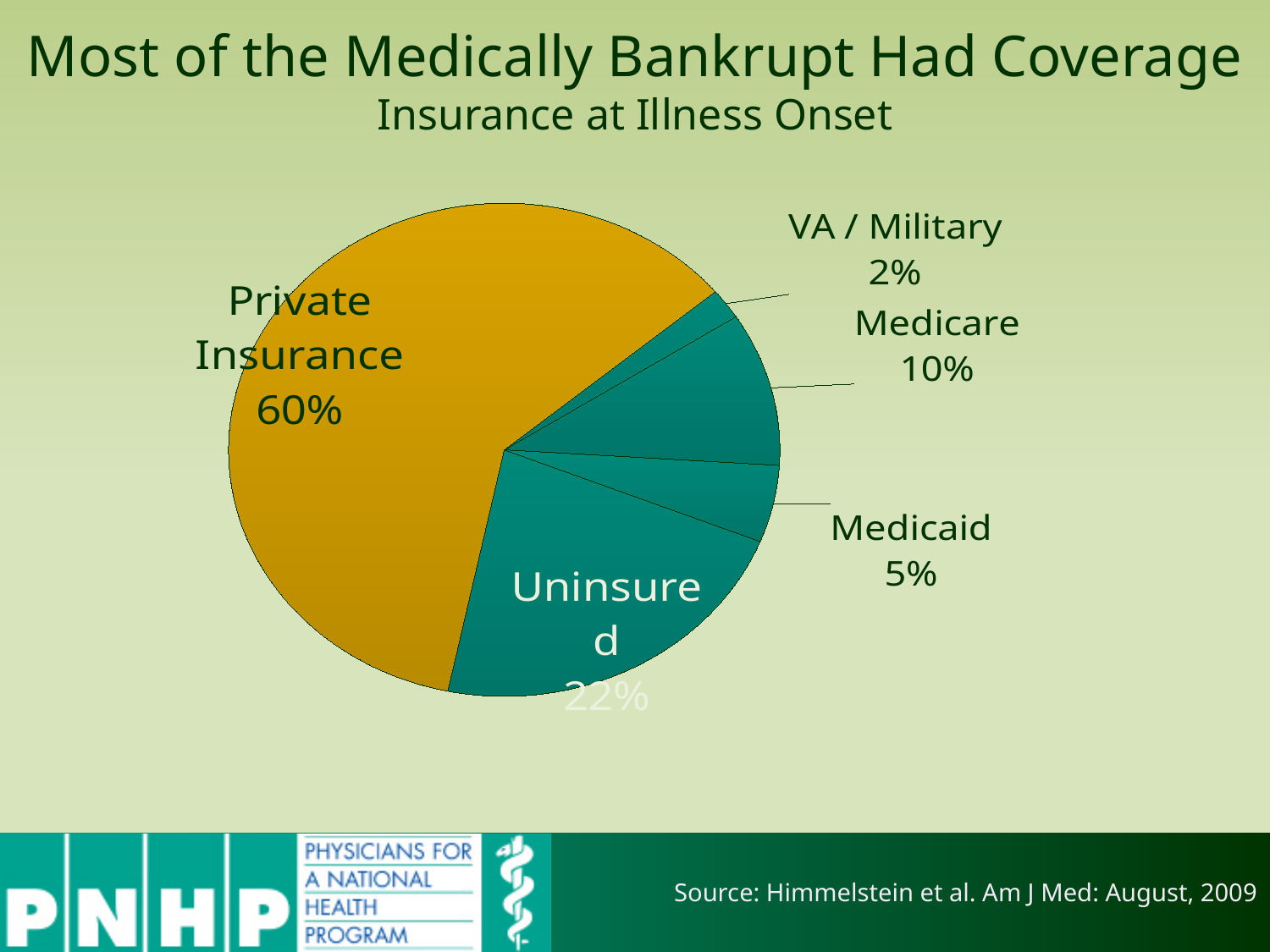
What share of the pie is Medicaid? 5% Which category has the smallest slice of the pie? VA / Military Which is larger, the Medicare slice or the Medicaid slice? Medicare What share of the pie is Uninsured? 22% What is the subtitle of the chart on the slide? Insurance at Illness Onset What share of the pie is Medicare? 10% Which category has the largest slice of the pie? Private Insurance How many slices does the pie chart have? 5 What is the difference in percentage points between Private Insurance and Uninsured? 38 What kind of chart is shown on the slide? pie chart